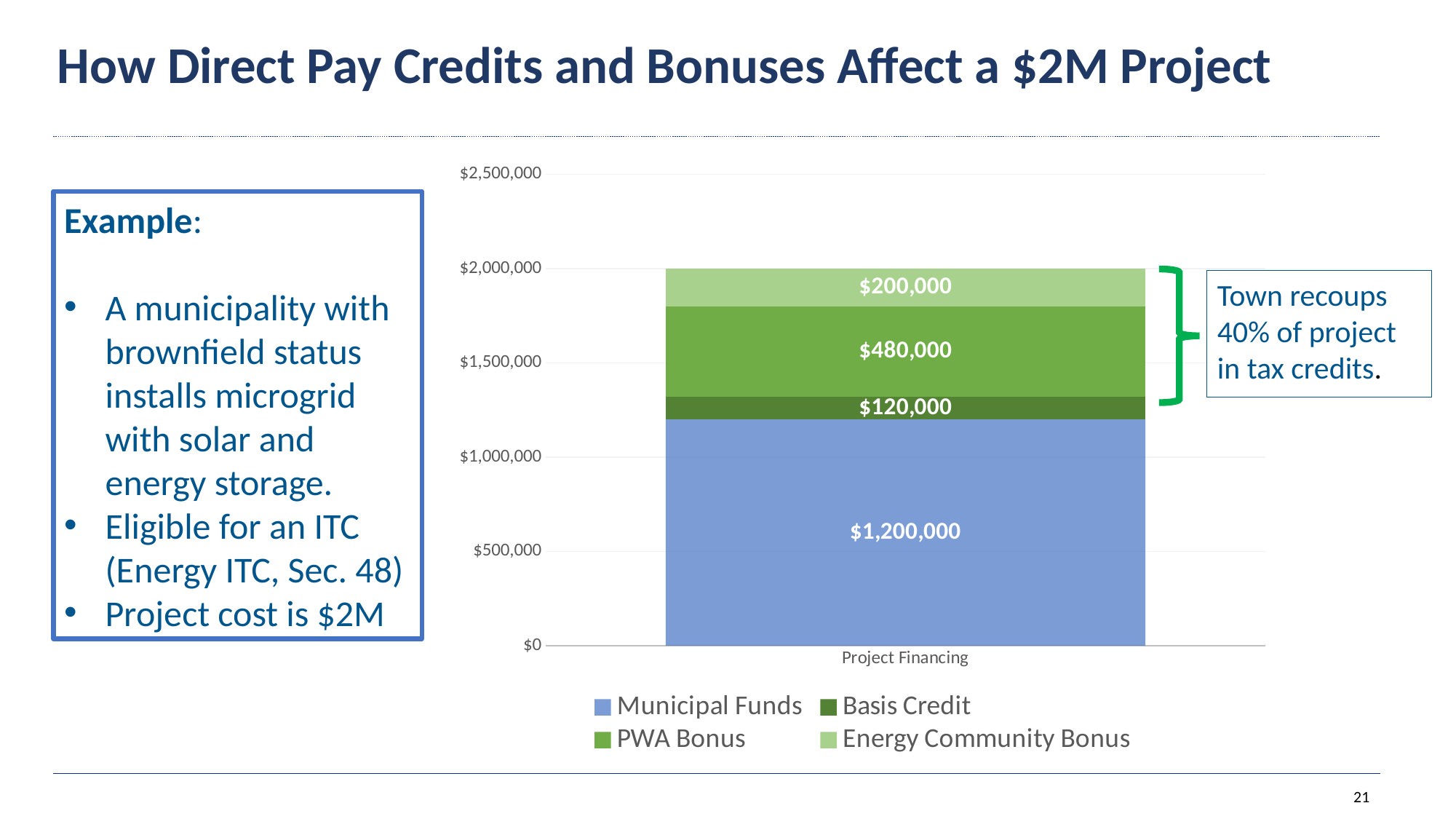
What is the category label on the x axis of the chart? Project Financing What is the value of the Basis Credit segment in the Project Financing bar? $120,000 What is the total of the stacked Project Financing bar? $2,000,000 Which is larger, the PWA Bonus segment or the Basis Credit segment? PWA Bonus What is the value of the Energy Community Bonus segment in the Project Financing bar? $200,000 What kind of chart is shown on the slide? Stacked bar chart What is the difference between the PWA Bonus and the Energy Community Bonus segments? $280,000 What is the value of the PWA Bonus segment in the Project Financing bar? $480,000 How many series does the legend list? 4 Which series has the smallest segment in the Project Financing bar? Basis Credit What is the value of the Municipal Funds segment in the Project Financing bar? $1,200,000 Which series has the largest segment in the Project Financing bar? Municipal Funds